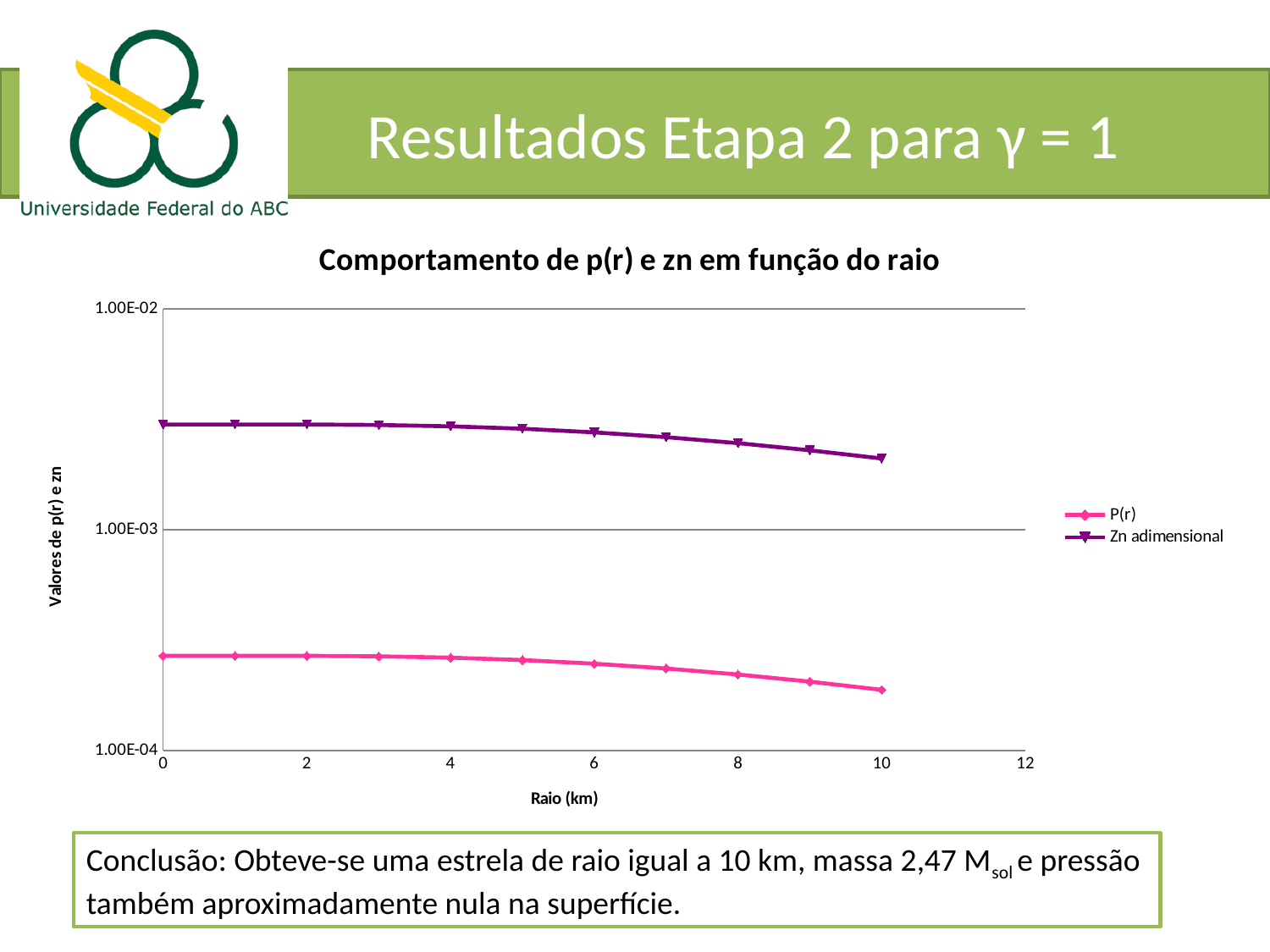
What kind of chart is shown on the slide? Line chart What are the two series named in the legend? P(r) and Zn adimensional How many series does the legend list? 2 How many data points are plotted for the P(r) series? 11 Is the value of Zn adimensional at Raio 0 km greater or less than 1.00E-03? greater Is the value of P(r) at Raio 10 km greater or less than 1.00E-03? less Do the values of the P(r) series rise or fall as Raio (km) increases? Fall At which Raio (km) value does the P(r) series reach its lowest point? 10 Which series has the higher values, P(r) or Zn adimensional? Zn adimensional What is the title of the chart? Comportamento de p(r) e zn em função do raio Is the value of P(r) at Raio 0 km greater or less than 1.00E-04? greater Do the values of the Zn adimensional series rise or fall as Raio (km) increases? Fall